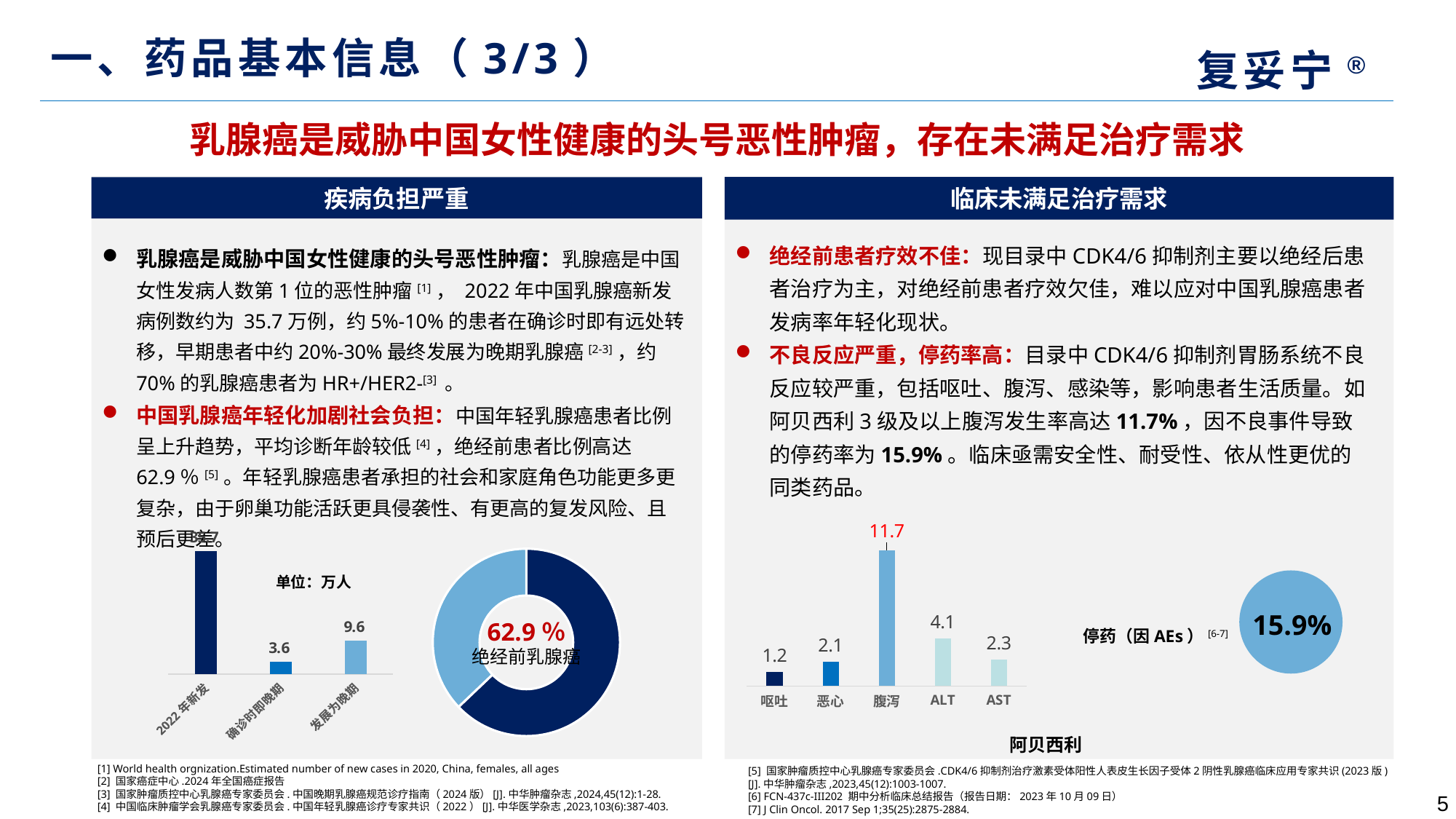
In the bar chart on the left side of the slide (单位：万人), what is the value for 确诊时即晚期? 3.6 In the bar chart titled 阿贝西利, what is the value for 腹泻? 11.7 In the bar chart titled 阿贝西利, which is larger, the value for 恶心 or the value for AST? AST In the bar chart on the left side of the slide (单位：万人), what is the value for 发展为晚期? 9.6 How many categories are shown in the bar chart titled 阿贝西利? 5 In the donut chart on the left side of the slide, what share is labelled 绝经前乳腺癌? 62.9 % In the bar chart titled 阿贝西利, which category has the highest value? 腹泻 What kind of chart is the 阿贝西利 chart on the right side of the slide? bar chart In the bar chart titled 阿贝西利, what is the value for 呕吐? 1.2 In the bar chart titled 阿贝西利, what is the value for ALT? 4.1 In the bar chart titled 阿贝西利, what is the difference between the values for 腹泻 and ALT? 7.6 In the bar chart titled 阿贝西利, which category has the lowest value? 呕吐